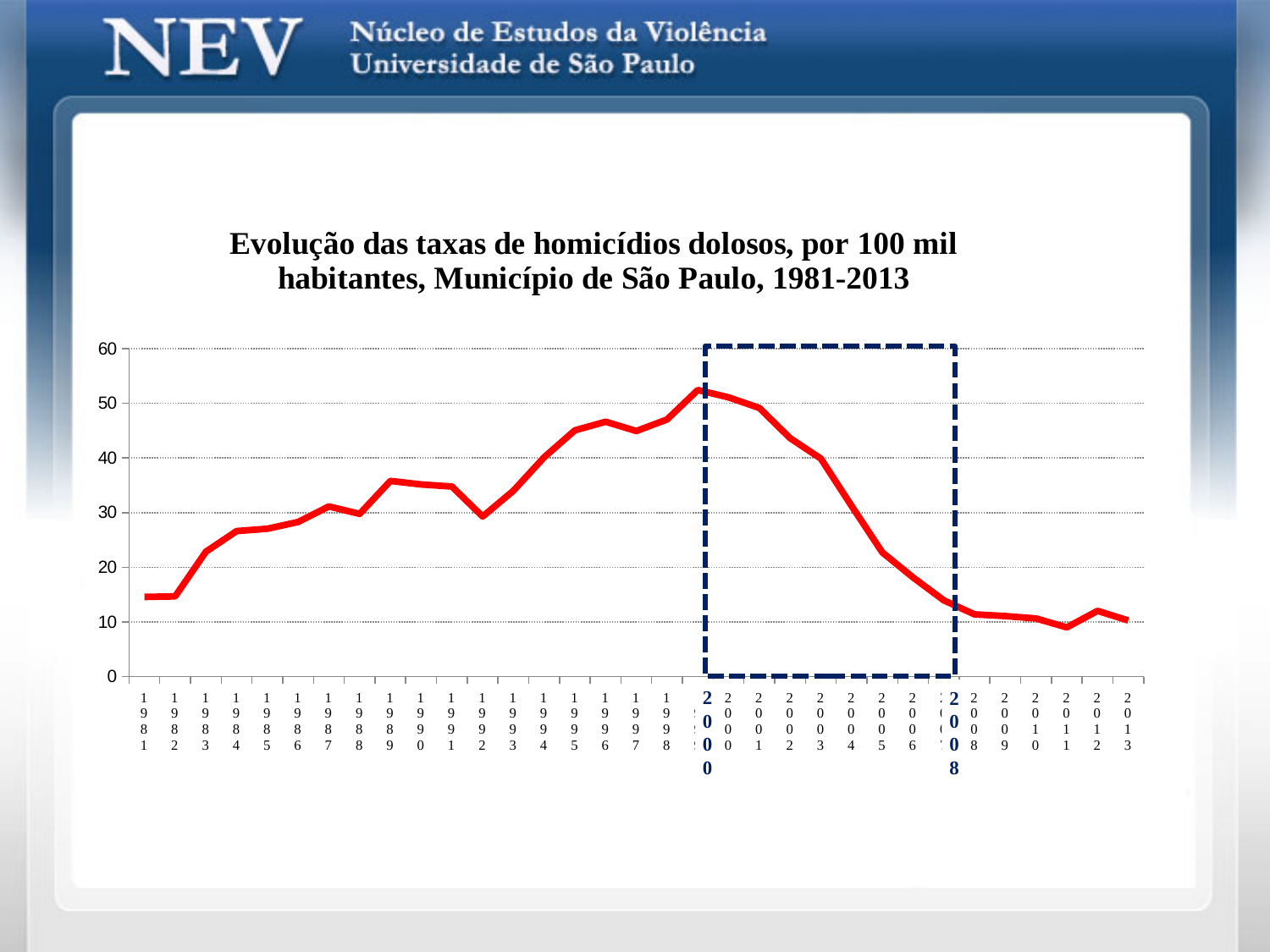
Is the homicide rate for 1999 greater or less than 50? greater Which year has a higher homicide rate, 1999 or 2013? 1999 What kind of chart is shown on the slide? line chart Which period is highlighted by the dashed box on the chart? 2000 to 2008 Which year has a higher homicide rate, 1989 or 1992? 1989 Is the homicide rate for 2003 greater or less than 30? greater Is the homicide rate for 1981 greater or less than 20? less Does the homicide rate rise or fall between 2000 and 2008? fall How many years are plotted along the x axis of the chart? 33 Which year has the lowest homicide rate on the chart? 2011